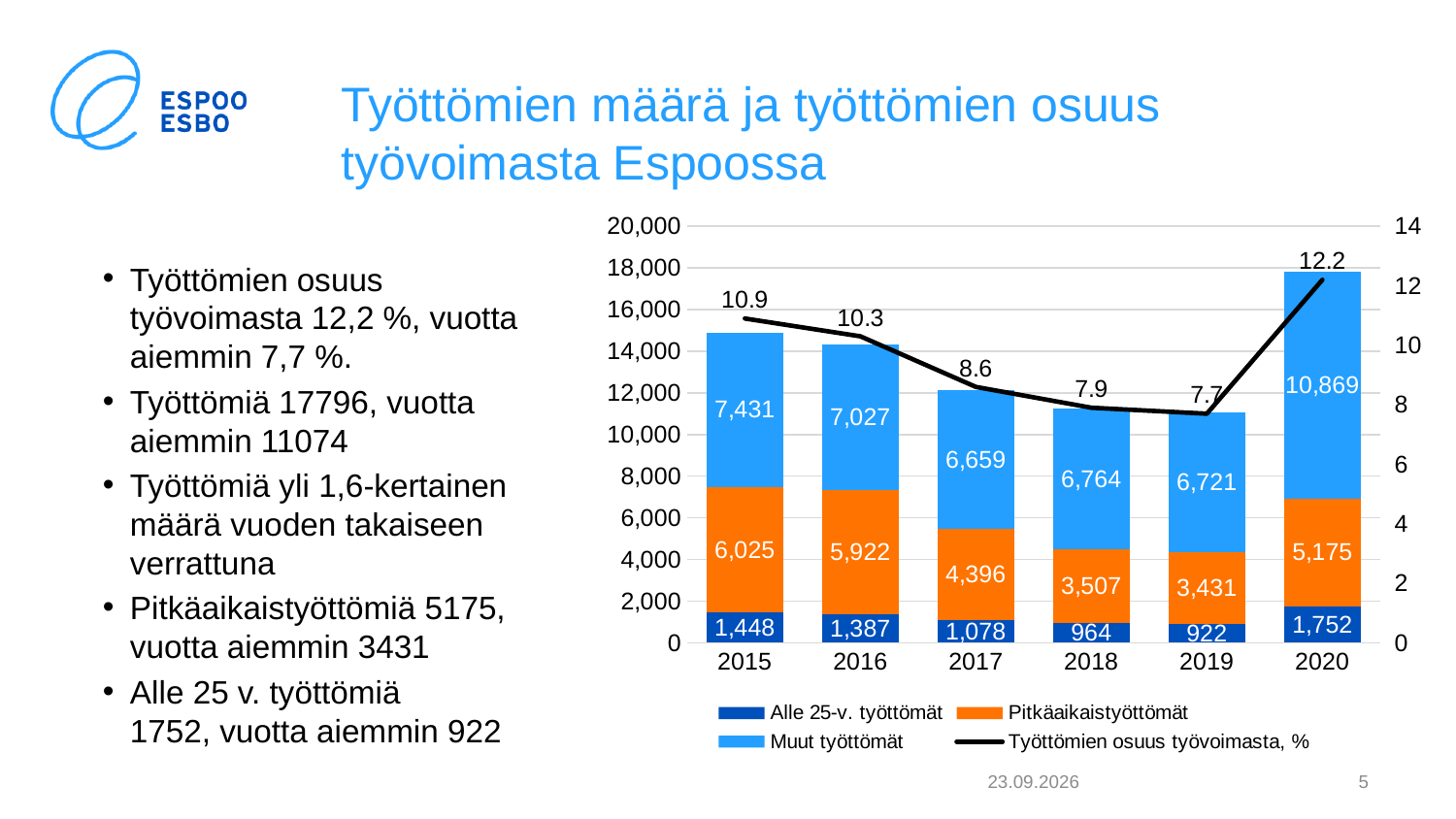
Does Työttömien osuus työvoimasta, % rise or fall from 2015 to 2019? Fall What kind of chart is shown on the slide? Stacked bar chart with a line What is the total of the stacked bar for 2020? 17,796 What is the value of Työttömien osuus työvoimasta, % in 2018? 7.9 In which year is Työttömien osuus työvoimasta, % lowest? 2019 In which year is the value for Alle 25-v. työttömät highest? 2020 Which year has the larger value for Alle 25-v. työttömät, 2015 or 2016? 2015 What is the value for Muut työttömät in 2020? 10,869 What is the value for Pitkäaikaistyöttömät in 2017? 4,396 How many years are shown on the x axis? 6 What is the difference between Pitkäaikaistyöttömät in 2020 and in 2019? 1,744 How many series does the legend list? 4